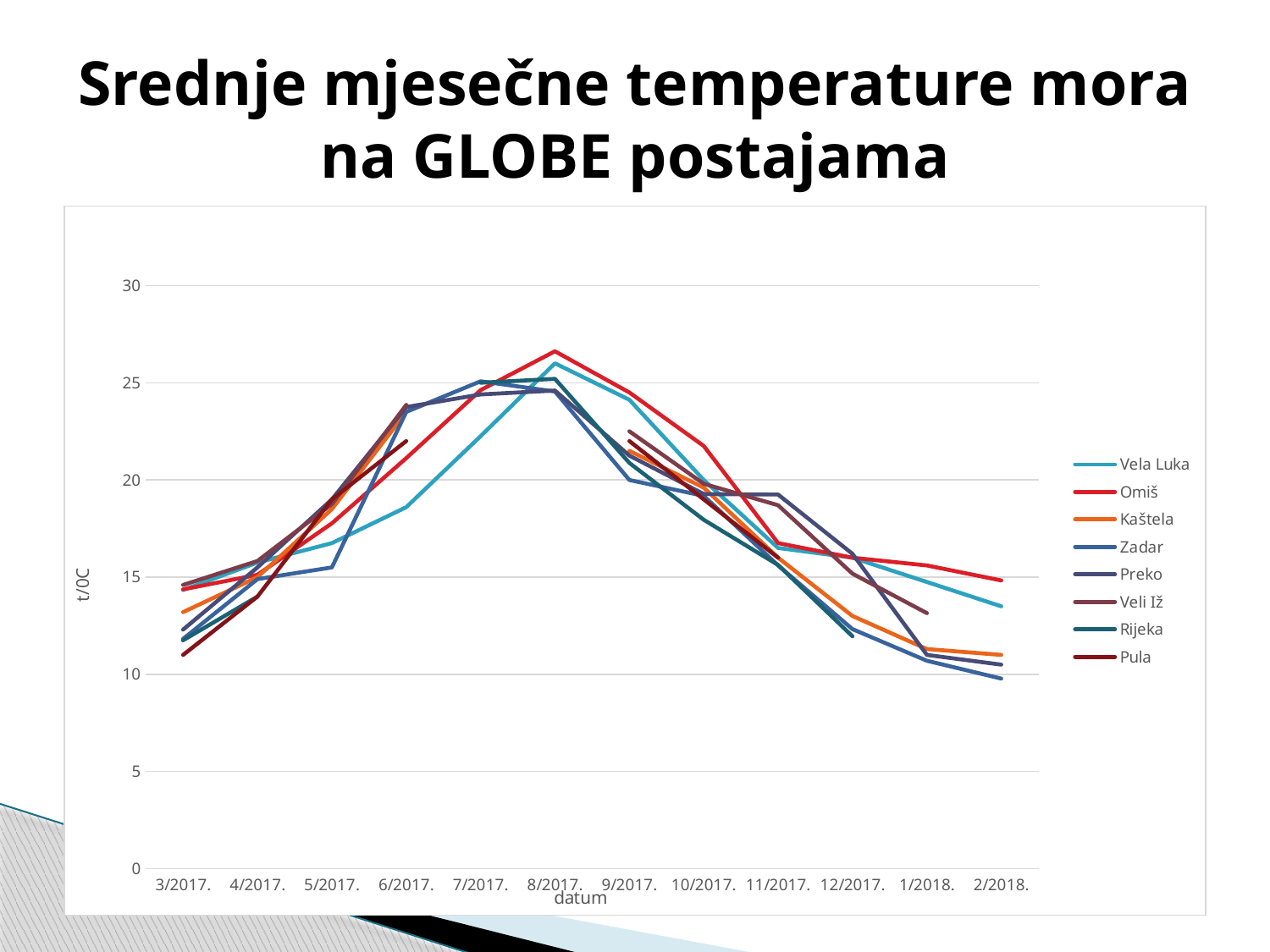
How many months are shown along the x axis? 12 How many series does the legend list? 8 Is the value for Omiš in 8/2017. greater or less than 25? greater What kind of chart is shown on the slide? line chart Which station has the highest value in 8/2017.? Omiš Is the value for Omiš in 10/2017. greater or less than 20? greater What is the label of the x axis? datum Do the values for Omiš rise or fall from 8/2017. to 2/2018.? fall Which is larger in 10/2017., the value for Omiš or the value for Vela Luka? Omiš Is the value for Vela Luka in 2/2018. greater or less than 15? less Which station has the lowest value in 3/2017.? Pula